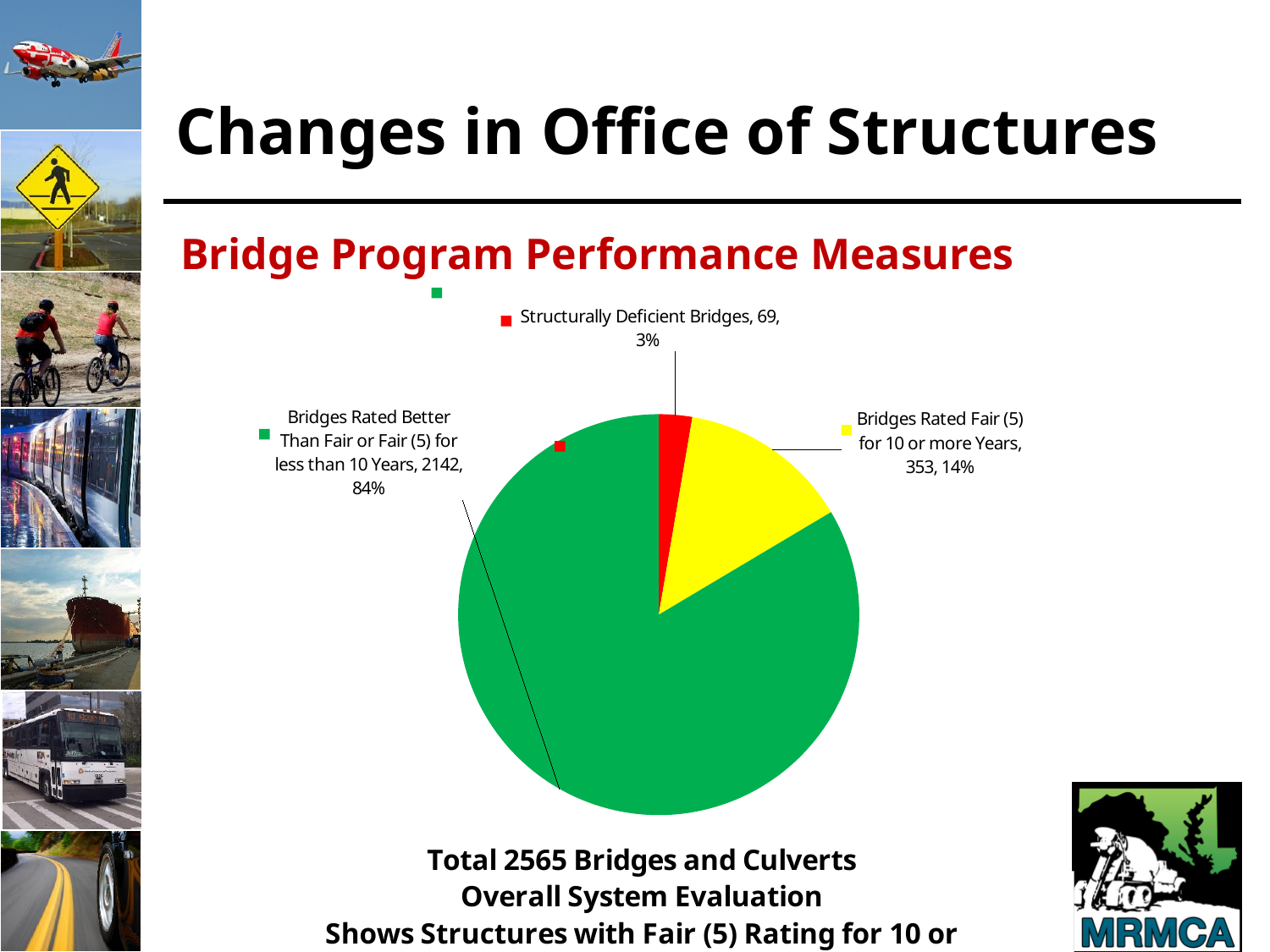
How many bridges are in the 'Bridges Rated Better Than Fair or Fair (5) for less than 10 Years' slice? 2142 What share of the pie is 'Bridges Rated Fair (5) for 10 or more Years'? 14% Which slice of the pie chart is the smallest? Structurally Deficient Bridges What colour is the Structurally Deficient Bridges slice? Red Which is larger: the Structurally Deficient Bridges slice or the Bridges Rated Fair (5) for 10 or more Years slice? Bridges Rated Fair (5) for 10 or more Years How many bridges are in the 'Bridges Rated Fair (5) for 10 or more Years' slice? 353 How many slices does the pie chart have? 3 Which slice of the pie chart is the largest? Bridges Rated Better Than Fair or Fair (5) for less than 10 Years What is the difference between the number of Bridges Rated Fair (5) for 10 or more Years and the number of Structurally Deficient Bridges? 284 How many Structurally Deficient Bridges are shown in the pie chart? 69 What percentage of the pie is Structurally Deficient Bridges? 3% What kind of chart is shown on the slide? Pie chart